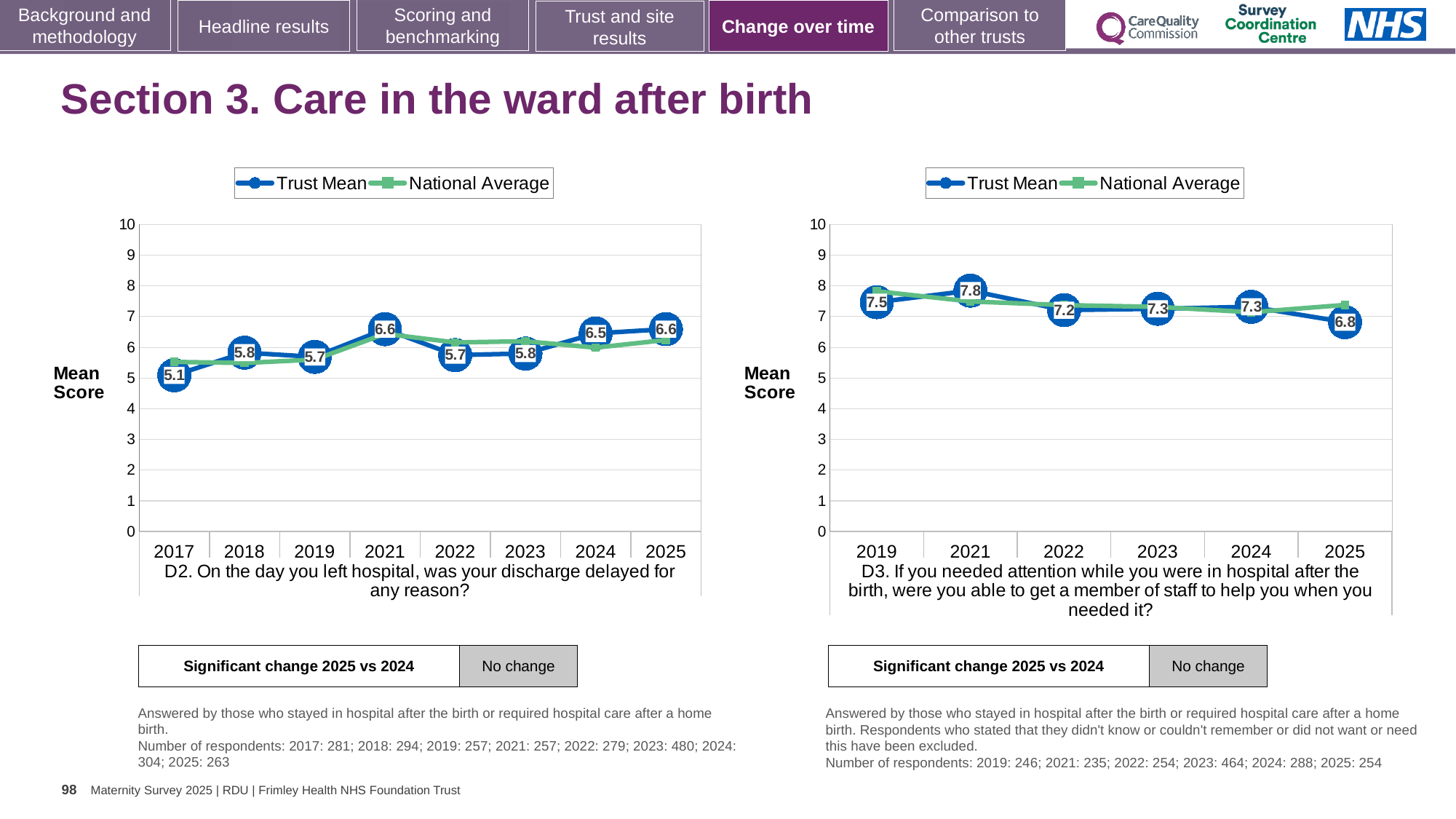
In the D2 chart (left), what is the Trust Mean score for 2024? 6.5 In the D3 chart (right), which year has the highest Trust Mean score? 2021 In the D2 chart (left), what is the difference between the Trust Mean scores for 2025 and 2017? 1.5 How many years are plotted on the x axis of the D3 chart (right)? 6 In the D3 chart (right), which is larger, the Trust Mean score for 2019 or for 2022? 2019 In the D2 chart (left), which year has the lowest Trust Mean score? 2017 In the D3 chart (right), which year has the lowest Trust Mean score? 2025 In the D2 chart (left), is the National Average value for 2017 greater or less than 5? greater In the D3 chart (right), what is the Trust Mean score for 2021? 7.8 In the D2 chart (left), what is the Trust Mean score for 2017? 5.1 In the D3 chart (right), what is the Trust Mean score for 2025? 6.8 How many series does the legend of the D2 chart (left) list? 2